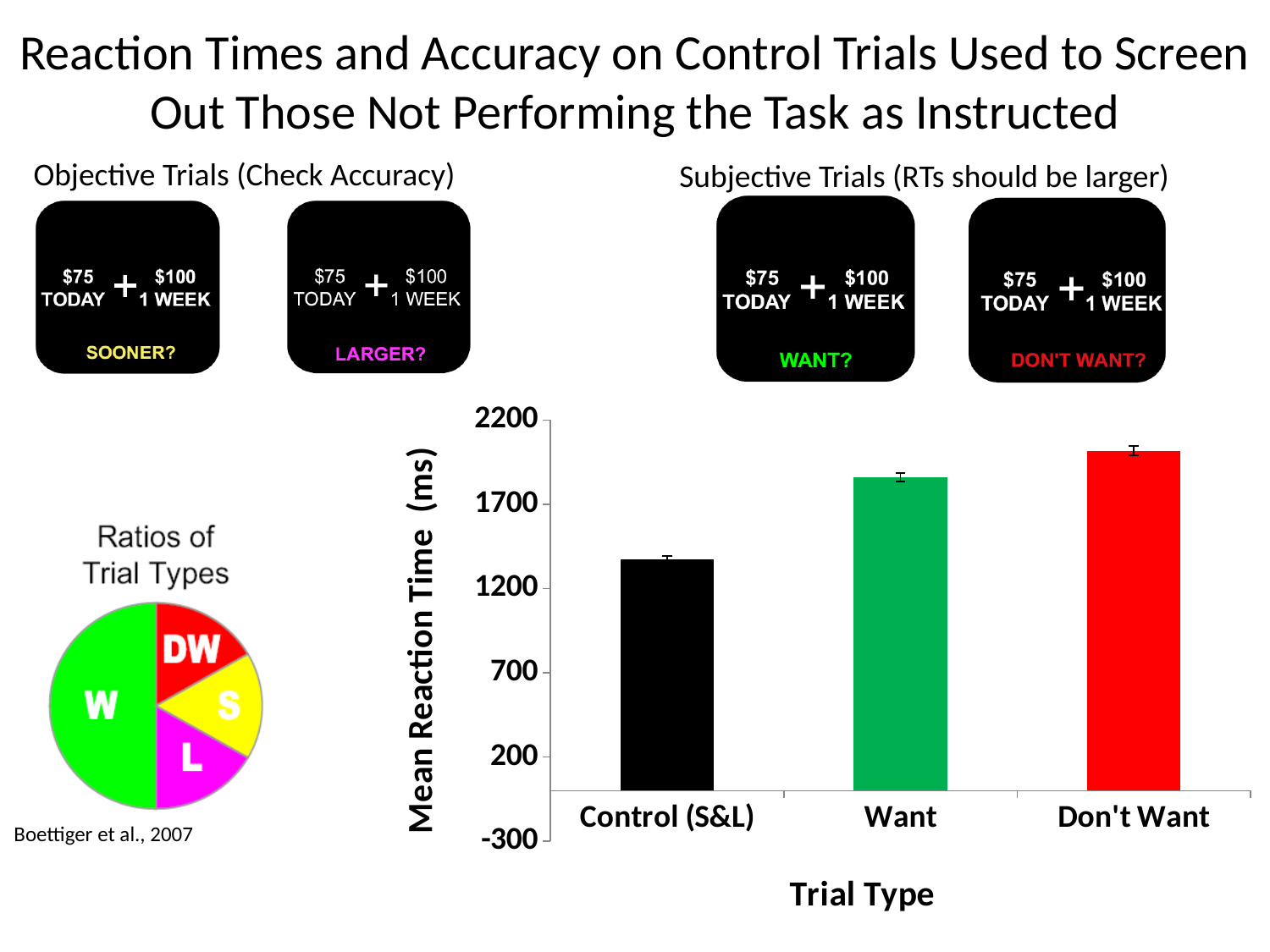
In the bar chart of mean reaction time, which trial type has the lowest mean reaction time? Control (S&L) In the bar chart of mean reaction time, is the value for Want greater or less than 1700? greater In the bar chart of mean reaction time, do the values rise or fall from left to right along the x axis? rise In the bar chart of mean reaction time, is the value for Don't Want greater or less than 2200? less In the bar chart of mean reaction time, is the value for Control (S&L) greater or less than 1200? greater In the bar chart of mean reaction time, which trial type has the highest mean reaction time? Don't Want What is the y axis title of the bar chart on the slide? Mean Reaction Time (ms) What kind of chart is the chart with the x axis labelled Trial Type? bar chart In the bar chart of mean reaction time, which is larger, the value for Want or the value for Control (S&L)? Want In the pie chart titled Ratios of Trial Types, how many slices are there? 4 In the bar chart of mean reaction time, how many trial types are shown on the x axis? 3